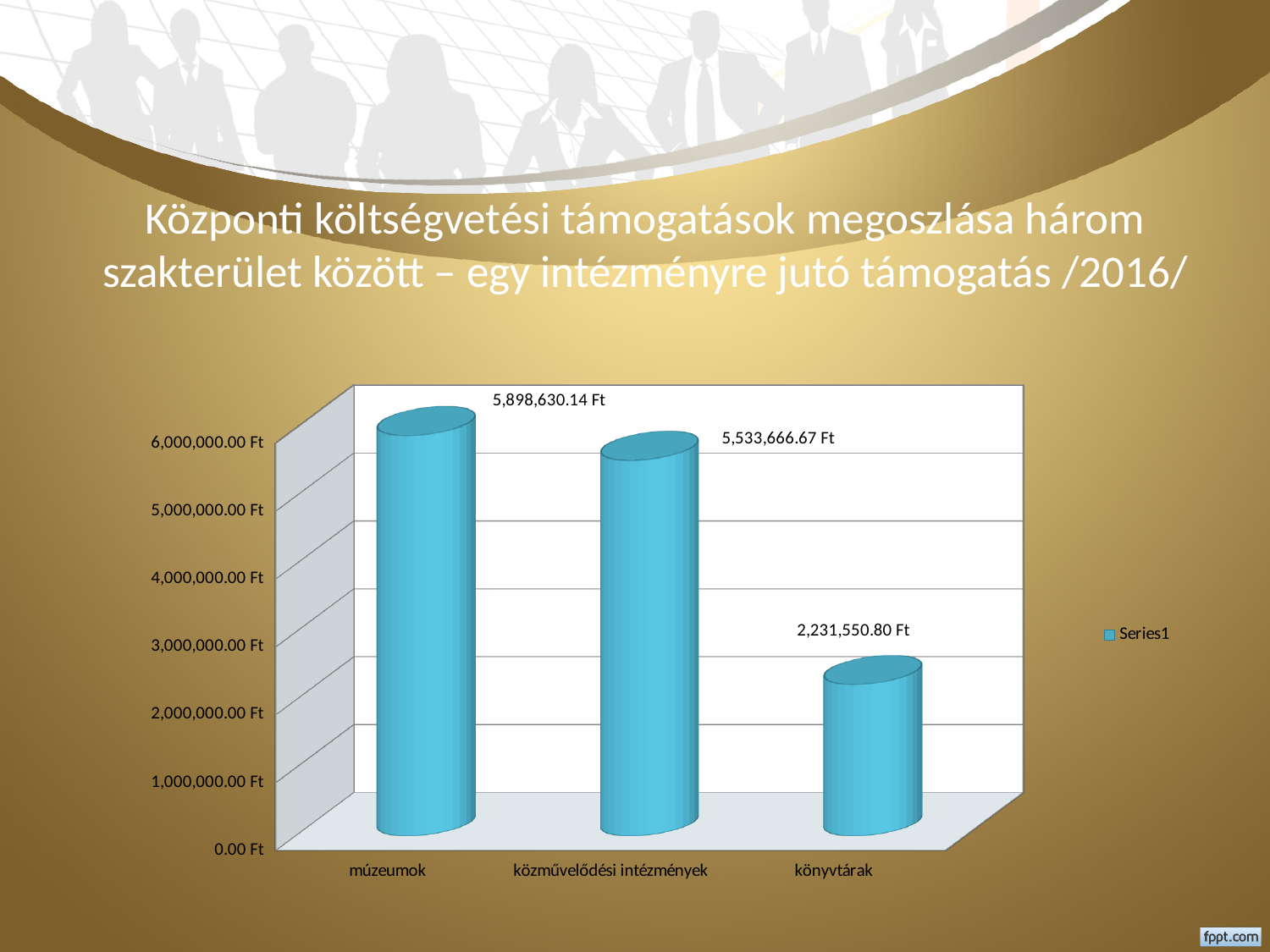
How many categories are shown on the x axis? 3 What is the difference between the values for múzeumok and közművelődési intézmények? 364,963.47 Ft Which category has the lowest value? könyvtárak Which is larger, the value for múzeumok or the value for könyvtárak? múzeumok What is the value for közművelődési intézmények? 5,533,666.67 Ft Is the value for könyvtárak greater or less than 3,000,000.00 Ft? less What is the value for múzeumok? 5,898,630.14 Ft Which category has the highest value? múzeumok What series name does the legend show? Series1 What is the difference between the values for közművelődési intézmények and könyvtárak? 3,302,115.87 Ft What kind of chart is shown on the slide? bar chart What is the value for könyvtárak? 2,231,550.80 Ft